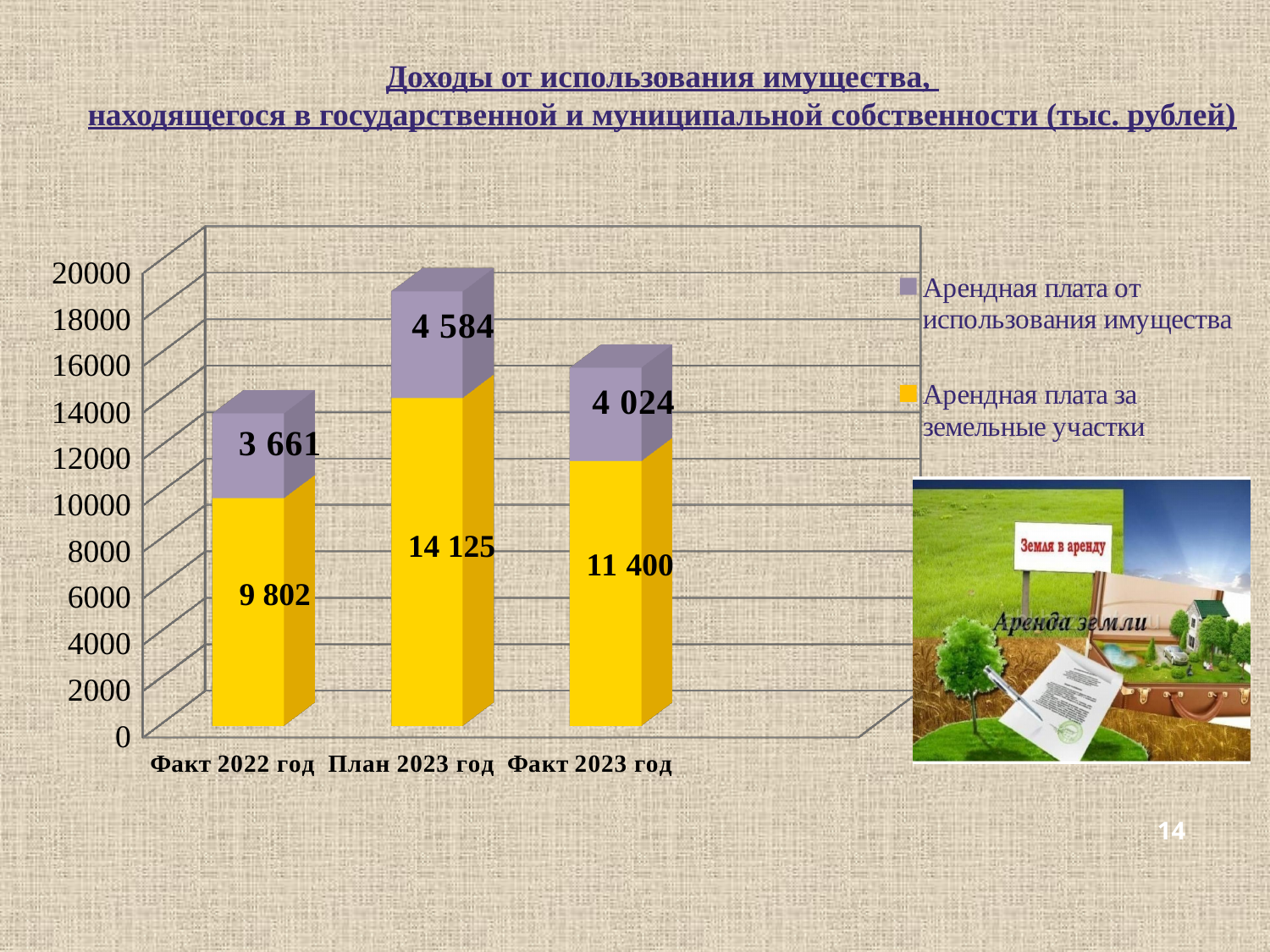
What is the total of the stacked bar for «Факт 2023 год»? 15 424 What is the difference between «Арендная плата за земельные участки» for «План 2023 год» and for «Факт 2023 год»? 2 725 Which is larger: «Арендная плата от использования имущества» for «Факт 2023 год» or for «Факт 2022 год»? Факт 2023 год How many categories are shown on the x axis of the chart? 3 How many series does the chart legend list? 2 What is the value of «Арендная плата за земельные участки» for «Факт 2022 год»? 9 802 Which category has the lowest value for «Арендная плата от использования имущества»? Факт 2022 год What is the value of «Арендная плата от использования имущества» for «План 2023 год»? 4 584 What is the total of the stacked bar for «Факт 2022 год»? 13 463 What is the value of «Арендная плата за земельные участки» for «Факт 2023 год»? 11 400 Which category has the highest value for «Арендная плата за земельные участки»? План 2023 год What is the value of «Арендная плата от использования имущества» for «Факт 2023 год»? 4 024